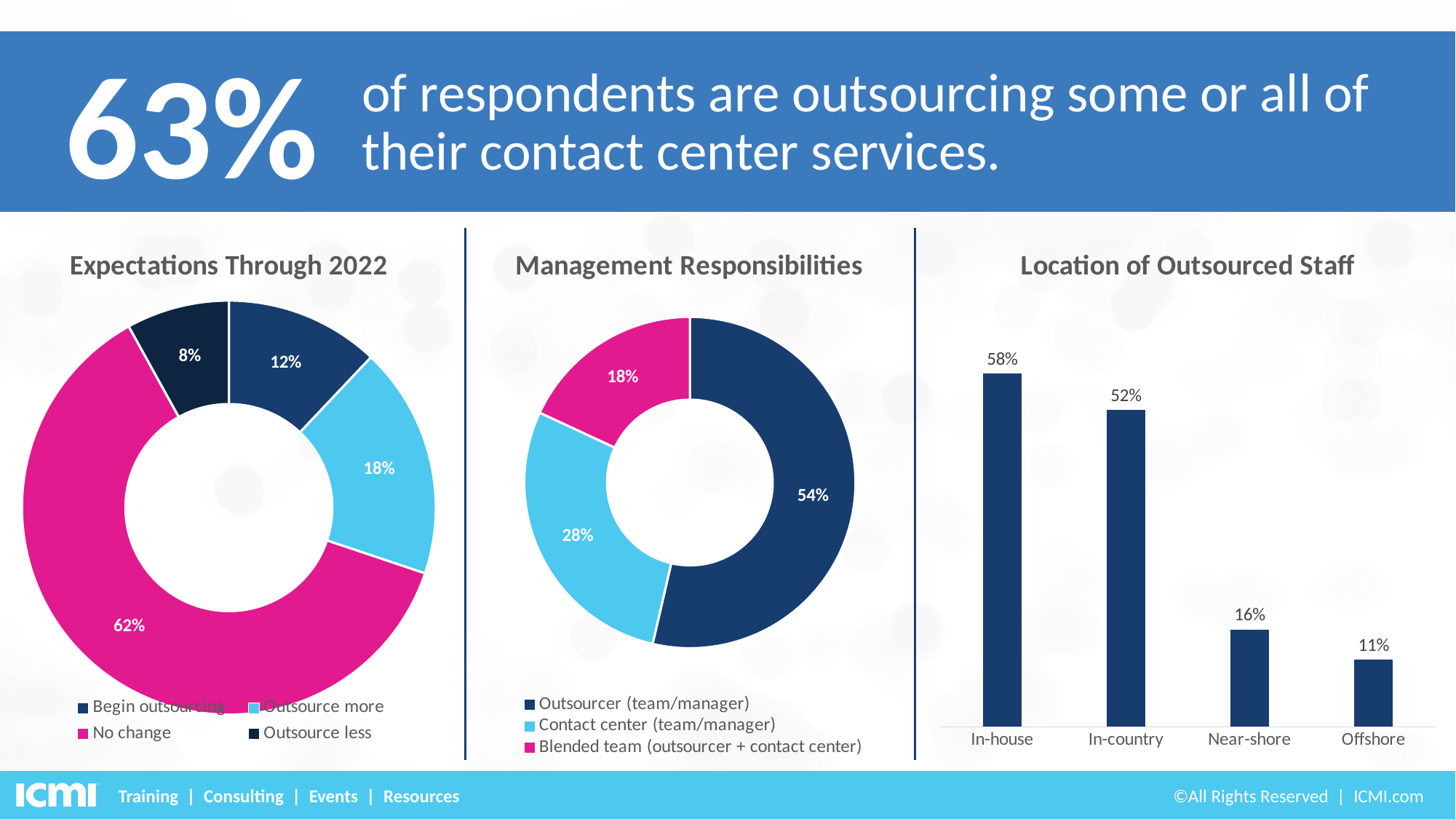
In the 'Management Responsibilities' chart, what percentage is shown for 'Outsourcer (team/manager)'? 54% In the 'Location of Outsourced Staff' chart, what is the difference between In-house and In-country? 6% In the 'Expectations Through 2022' chart, what percentage is shown for 'Outsource less'? 8% In the 'Management Responsibilities' chart, which category has the smallest share? Blended team (outsourcer + contact center) In the 'Location of Outsourced Staff' chart, do the values rise or fall from In-house to Offshore? Fall In the 'Expectations Through 2022' chart, which category has the largest share? No change In the 'Expectations Through 2022' chart, what share of respondents expect no change? 62% In the 'Management Responsibilities' chart, how many categories does the legend list? 3 In the 'Location of Outsourced Staff' chart, what is the value for Near-shore? 16% In the 'Expectations Through 2022' chart, what is the difference between 'Outsource more' and 'Begin outsourcing'? 6% What kind of chart is 'Location of Outsourced Staff'? Bar chart In the 'Location of Outsourced Staff' chart, which location has the lowest value? Offshore